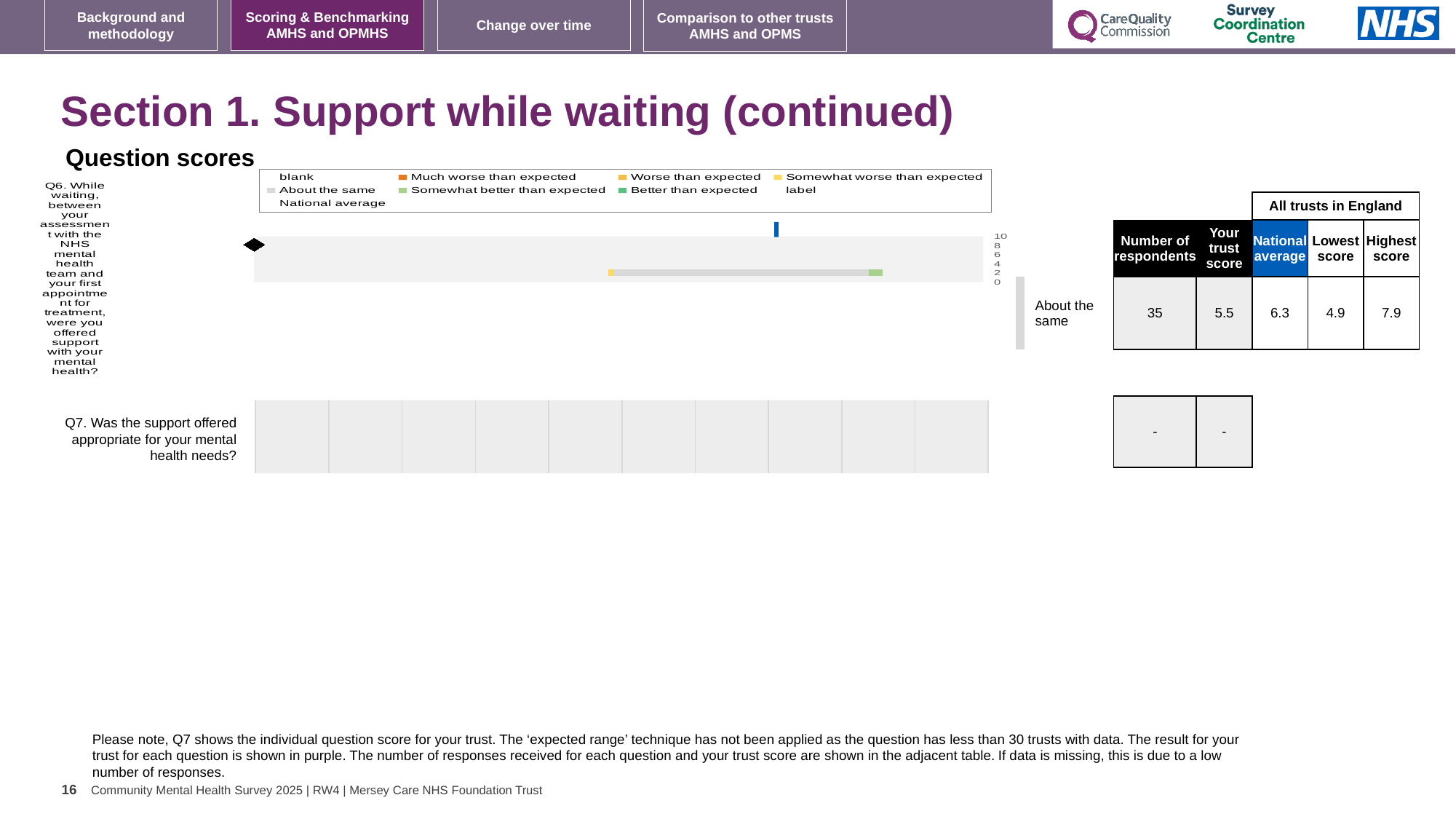
What is the national average score for Q6? 6.3 What is the trust score for Q6 shown in the table next to the chart? 5.5 What kind of chart is used to show the question scores? Bar chart By how much does the national average exceed the trust score for Q6? 0.8 For Q6, which is larger: the trust score or the national average? National average How many questions are plotted on the chart? 2 What is the difference between the highest and lowest trust scores for Q6? 3.0 What category label is shown for the trust's Q6 result? About the same What is shown as the number of respondents for Q7? - How many respondents answered Q6? 35 What is the highest score among all trusts in England for Q6? 7.9 What is the lowest score among all trusts in England for Q6? 4.9